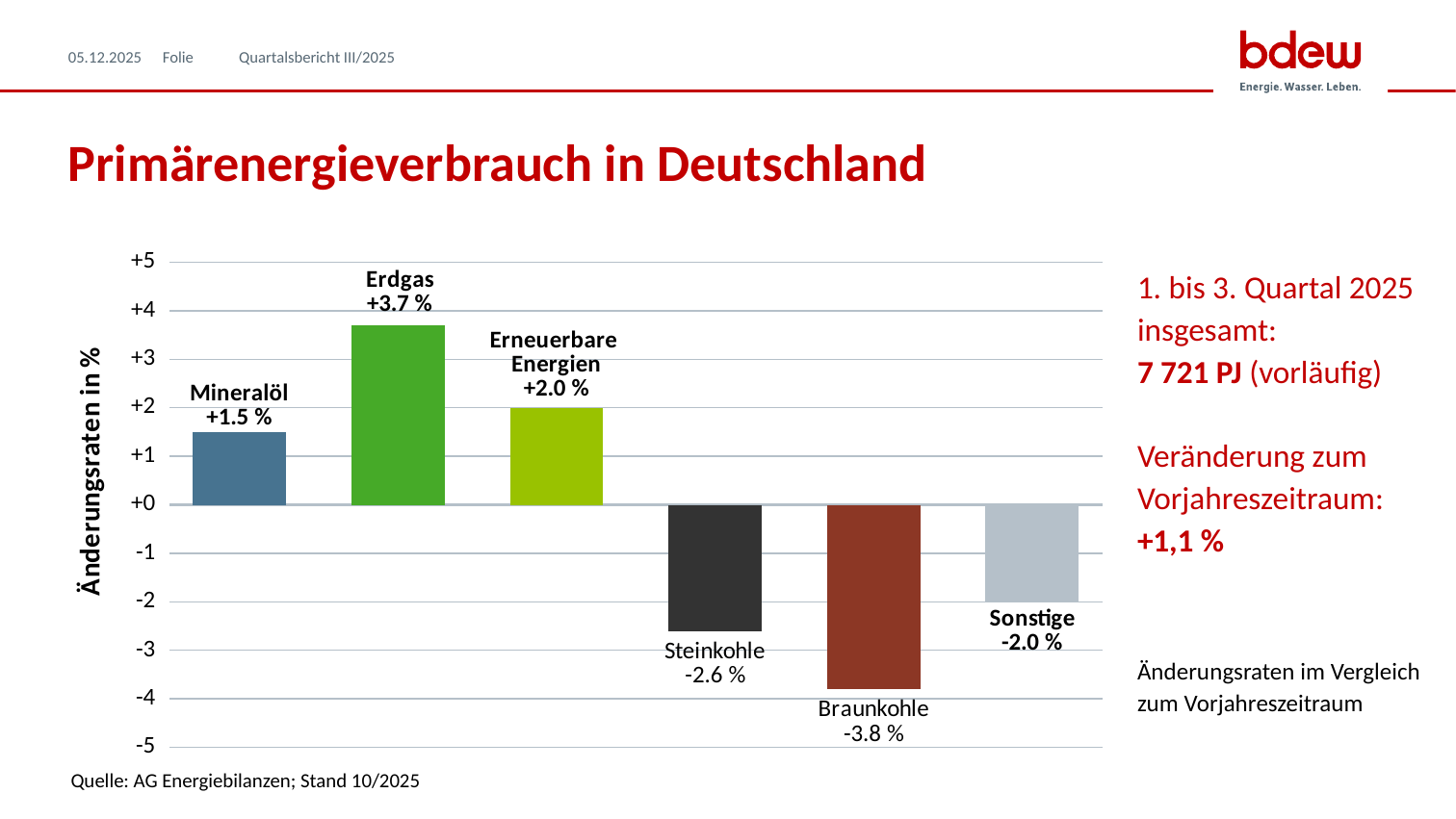
What is the change rate shown for Erdgas? +3.7 % What is the change rate shown for Braunkohle? -3.8 % What is the change rate shown for Erneuerbare Energien? +2.0 % What is the difference between the change rates of Erdgas and Mineralöl? 2.2 percentage points What is the title of the slide? Primärenergieverbrauch in Deutschland Is the value for Steinkohle greater or less than -2? less What is the label of the vertical axis? Änderungsraten in % How many categories are shown in the chart? 6 Which has a larger change rate, Mineralöl or Erneuerbare Energien? Erneuerbare Energien Which category has the highest change rate? Erdgas What kind of chart is shown on the slide? Bar chart Which category has the lowest change rate? Braunkohle